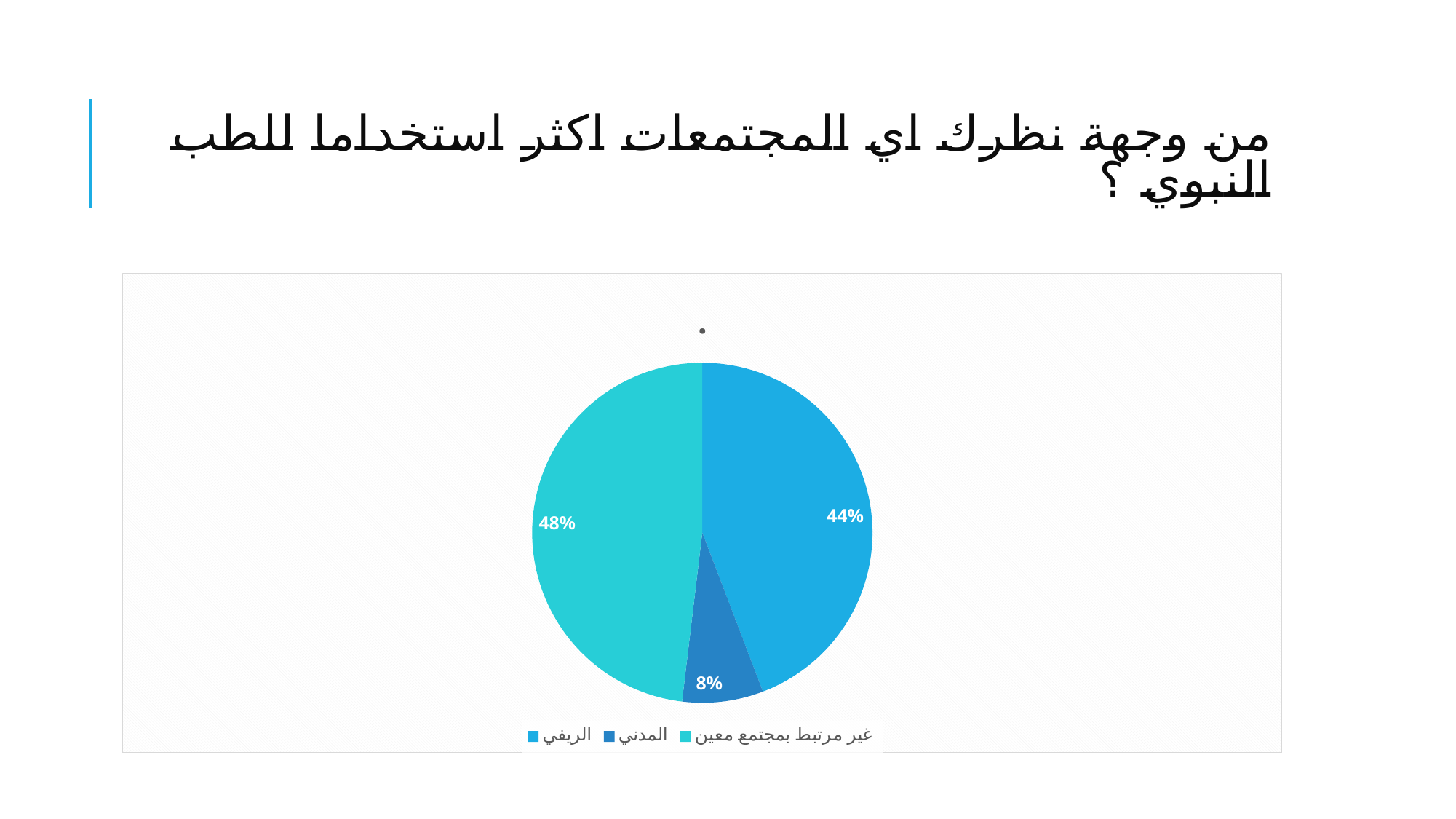
Which category has the smallest slice of the pie chart? المدني What percentage of the pie chart is the slice for غير مرتبط بمجتمع معين? 48% What kind of chart is shown on the slide? Pie chart What percentage of the pie chart is the slice for الريفي? 44% What colour is the slice for المدني in the pie chart? Dark blue What percentage of the pie chart is the slice for المدني? 8% Which slice is larger, الريفي or المدني? الريفي How many entries does the legend of the chart list? 3 Which category has the largest slice of the pie chart? غير مرتبط بمجتمع معين How many slices does the pie chart have? 3 What is the difference in percentage points between the slices for الريفي and المدني? 36 percentage points What is the difference in percentage points between the slices for غير مرتبط بمجتمع معين and الريفي? 4 percentage points